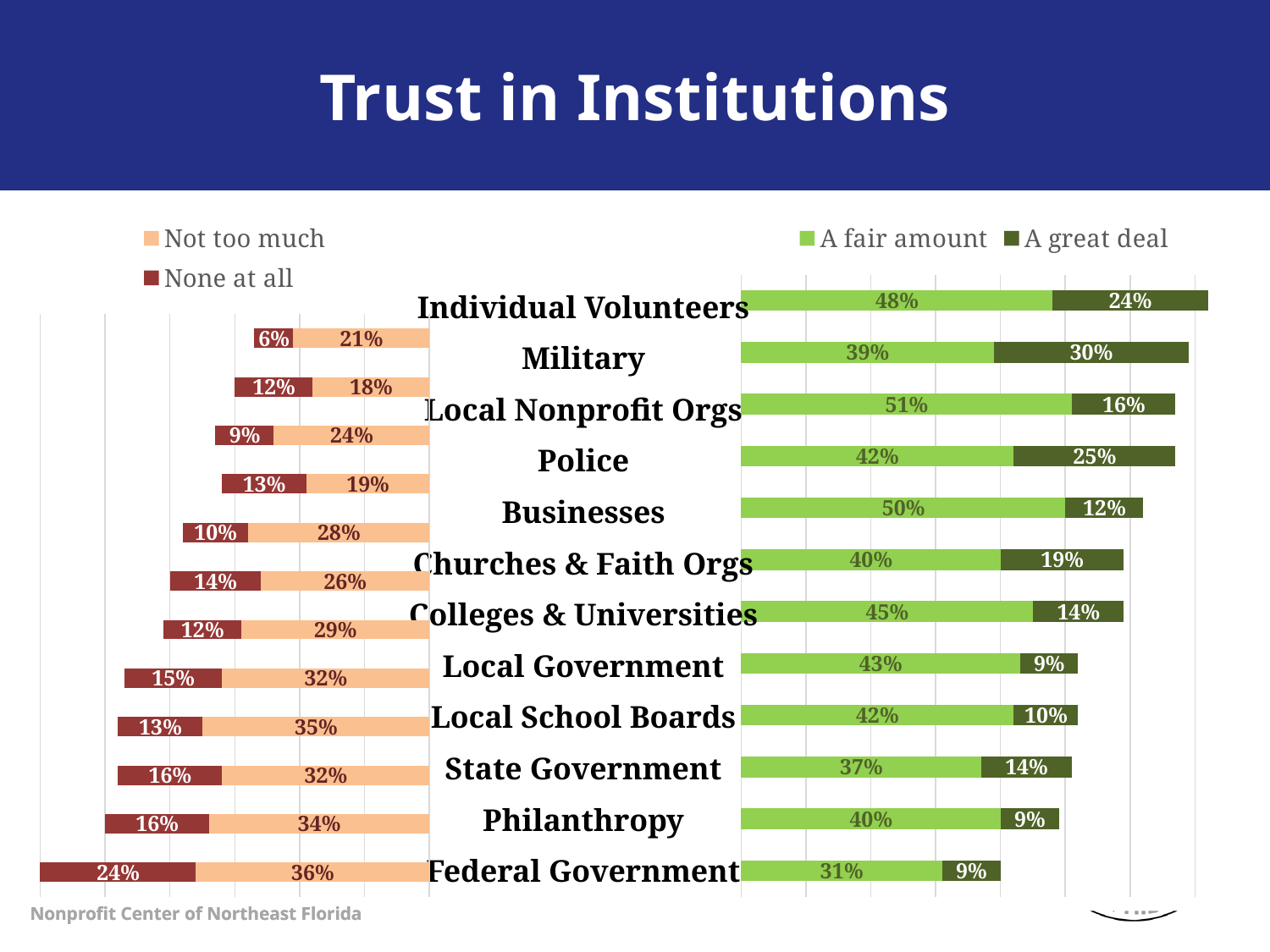
What kind of chart is shown on the slide? Bar chart Which institution has the lowest 'A fair amount' value? Federal Government What is the difference between the 'A fair amount' values for Businesses and Federal Government? 19% How many series does the legend list? 4 What percentage of respondents have 'A great deal' of trust in the Military? 30% What is the 'Not too much' value for Local School Boards? 35% Which institution has the highest 'A great deal' value? Military How many institutions are listed in the chart? 12 What is the 'A fair amount' value for Local Nonprofit Orgs? 51% Which is larger: the 'A great deal' value for Police or for Churches & Faith Orgs? Police What is the combined 'A fair amount' and 'A great deal' total for Individual Volunteers? 72% What is the 'None at all' value for Federal Government? 24%